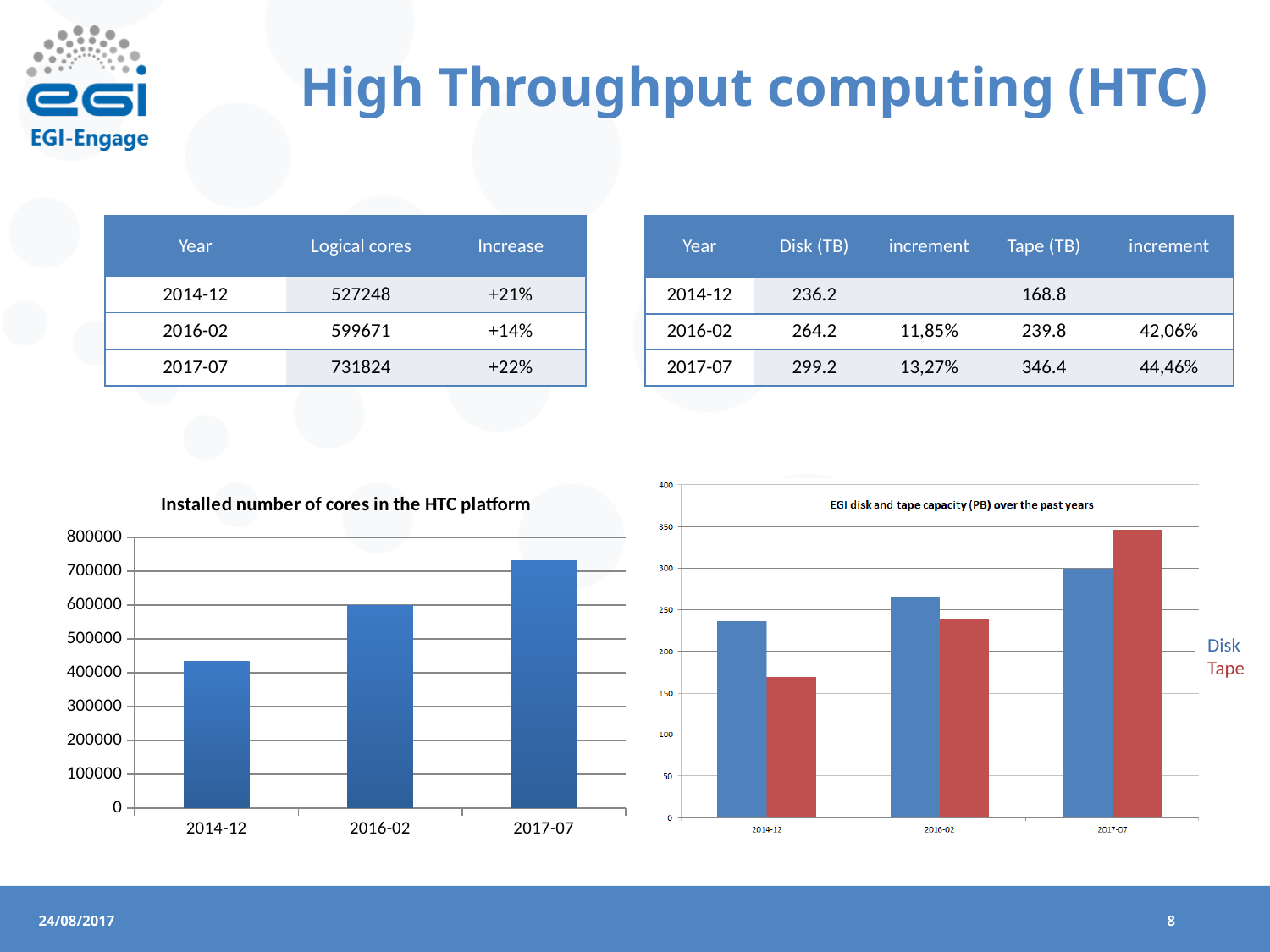
In the 'EGI disk and tape capacity (PB) over the past years' chart, which series and year has the tallest bar? Tape, 2017-07 In the 'EGI disk and tape capacity (PB) over the past years' chart, which colour represents Tape? red In the 'Installed number of cores in the HTC platform' chart, is the value for 2017-07 greater or less than 700000? greater In the 'Installed number of cores in the HTC platform' chart, do the values rise or fall from 2014-12 to 2017-07? rise In the 'EGI disk and tape capacity (PB) over the past years' chart, is Disk or Tape larger in 2014-12? Disk How many series does the legend of the 'EGI disk and tape capacity (PB) over the past years' chart list? 2 What kind of chart is the 'Installed number of cores in the HTC platform' chart? bar chart In the 'Installed number of cores in the HTC platform' chart, which year has the highest bar? 2017-07 In the 'Installed number of cores in the HTC platform' chart, which year has the lowest bar? 2014-12 In the 'Installed number of cores in the HTC platform' chart, how many years are shown on the x axis? 3 In the 'Installed number of cores in the HTC platform' chart, is the value for 2014-12 greater or less than 500000? less In the 'EGI disk and tape capacity (PB) over the past years' chart, is the Tape value for 2014-12 greater or less than 200? less